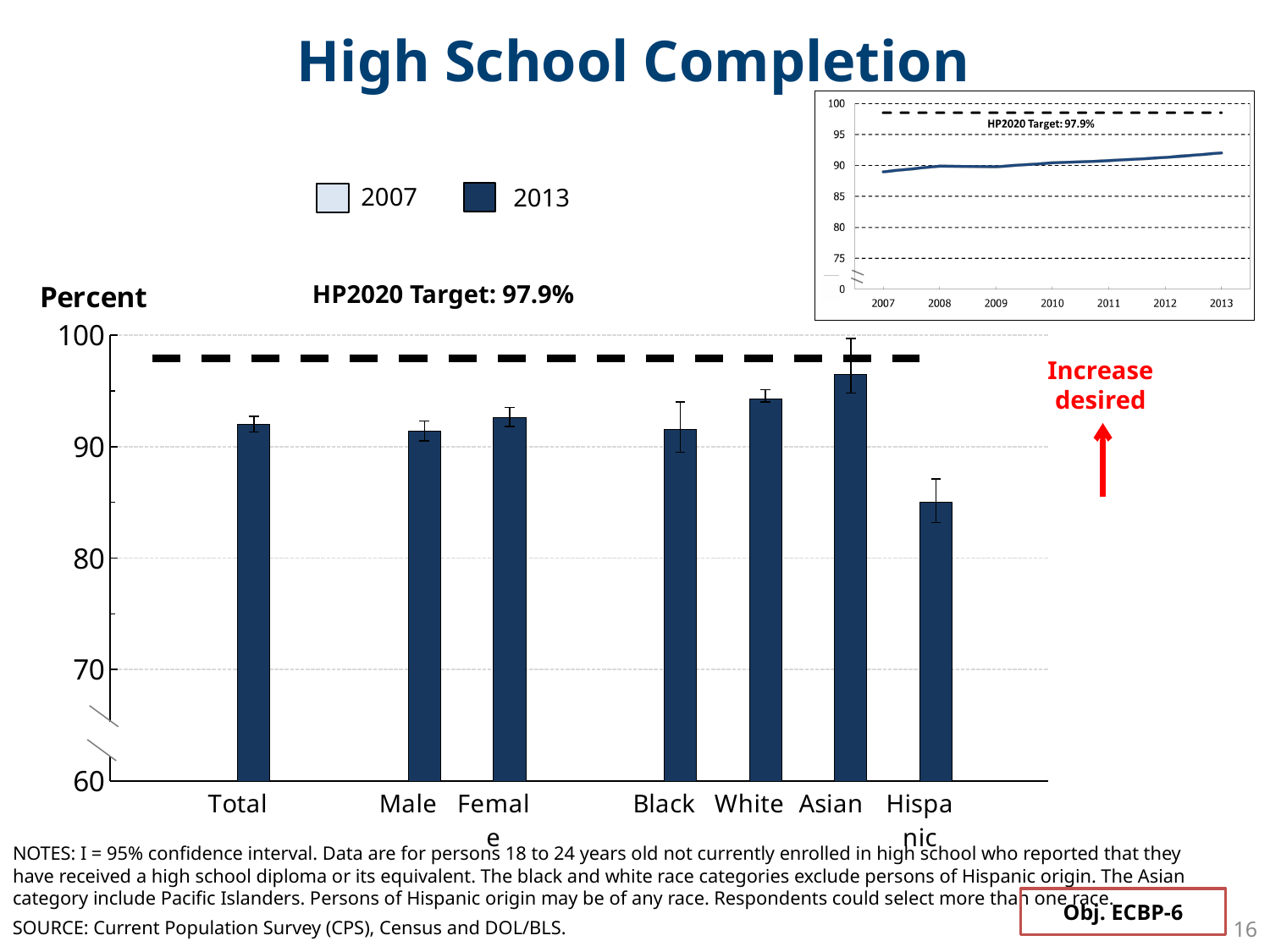
What HP2020 target value is shown on the main bar chart? 97.9% In the main bar chart, which bar is taller, White or Black? White In the main bar chart, is the value for Asian greater or less than 95? greater In the main bar chart, which category has the highest bar? Asian In the main bar chart, is the value for Hispanic greater or less than 90? less How many series does the legend of the main bar chart list? 2 In the main bar chart, which category has the lowest bar? Hispanic What kind of chart is the main chart on the slide? bar chart In the main bar chart, which bar is taller, Hispanic or Total? Total In the small inset line chart at the top right, do the values rise or fall from 2007 to 2013? rise In the main bar chart, how many categories are shown on the x axis? 7 In the main bar chart, is the value for Total greater or less than 90? greater